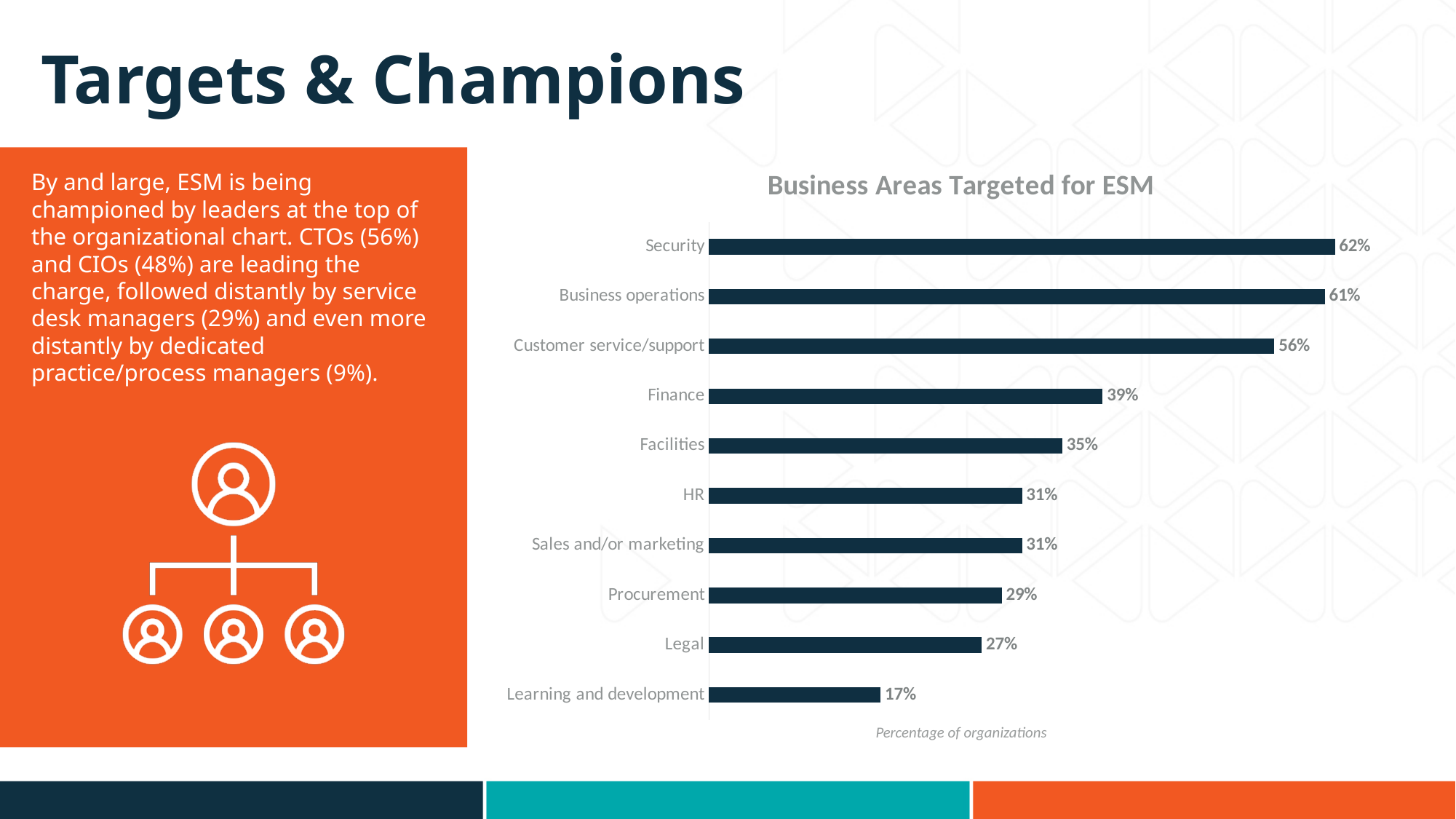
What is the title of the chart? Business Areas Targeted for ESM How many business areas are shown in the chart? 10 Which business area has the highest value in the chart? Security What percentage of organizations target Finance for ESM? 39% What is the difference between the values for Security and Business operations? 1% What is the difference between the values for Customer service/support and Legal? 29% What kind of chart is shown on the slide? Bar chart Which has a larger value, Facilities or Procurement? Facilities Which business area has the lowest value in the chart? Learning and development What does the axis caption below the chart say the values represent? Percentage of organizations What is the value for Security in the Business Areas Targeted for ESM chart? 62% What is the value for Learning and development? 17%